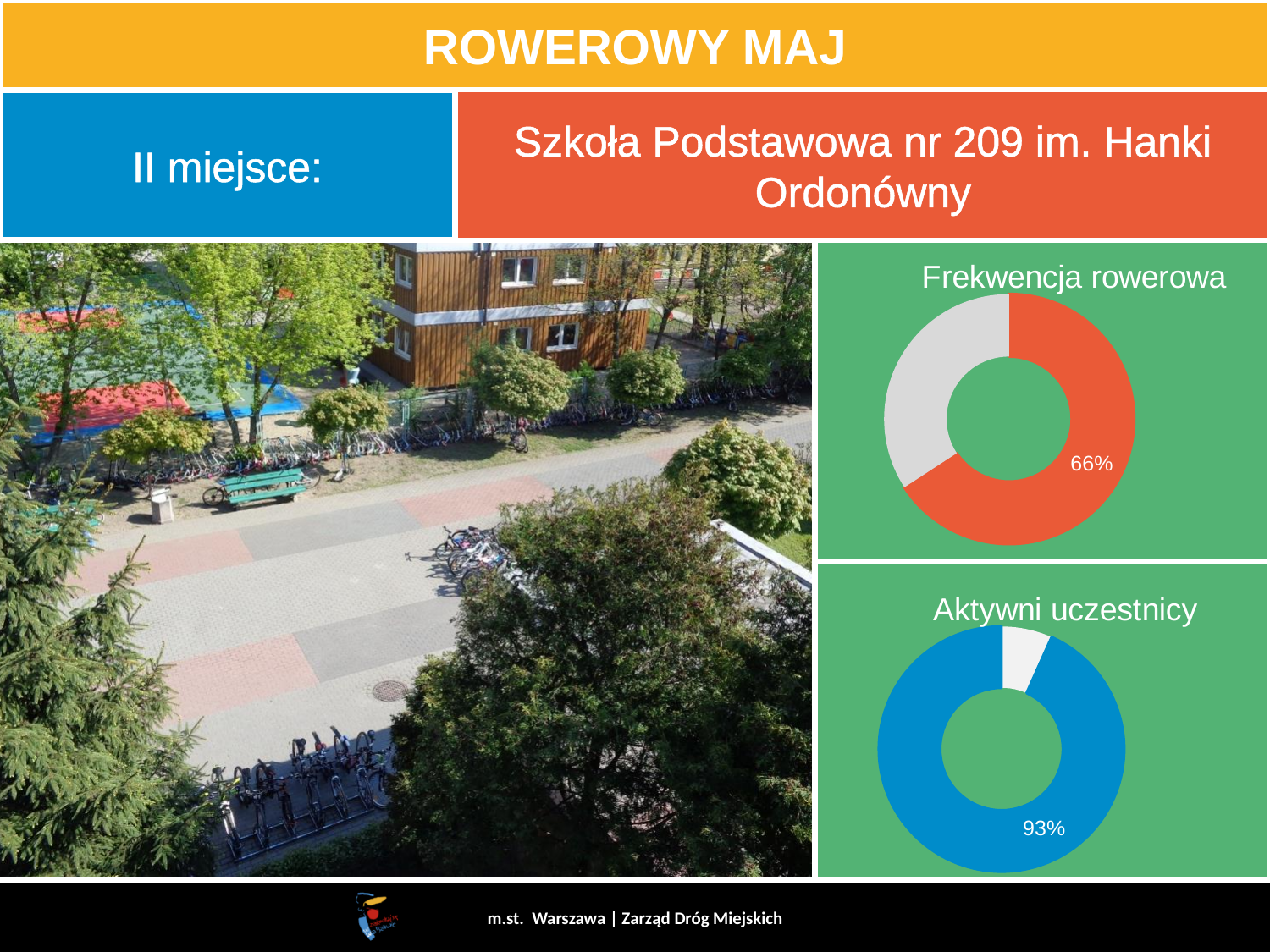
What kind of chart is 'Frekwencja rowerowa'? Donut chart What kind of chart is 'Aktywni uczestnicy'? Donut chart In the 'Aktywni uczestnicy' chart, is the labelled value greater or less than 90%? greater What colour is the labelled segment in the 'Aktywni uczestnicy' chart? Blue In the 'Aktywni uczestnicy' chart, what percentage is shown on the blue segment? 93% What is the difference between the percentage labelled in 'Aktywni uczestnicy' and the percentage labelled in 'Frekwencja rowerowa'? 27% What is the title of the upper chart on the right side of the slide? Frekwencja rowerowa Which chart shows the larger labelled percentage, 'Frekwencja rowerowa' or 'Aktywni uczestnicy'? Aktywni uczestnicy In the 'Frekwencja rowerowa' chart, what percentage is shown on the orange segment? 66% How many segments does the 'Frekwencja rowerowa' donut chart have? 2 In the 'Frekwencja rowerowa' chart, is the labelled value greater or less than 50%? greater How many segments does the 'Aktywni uczestnicy' donut chart have? 2